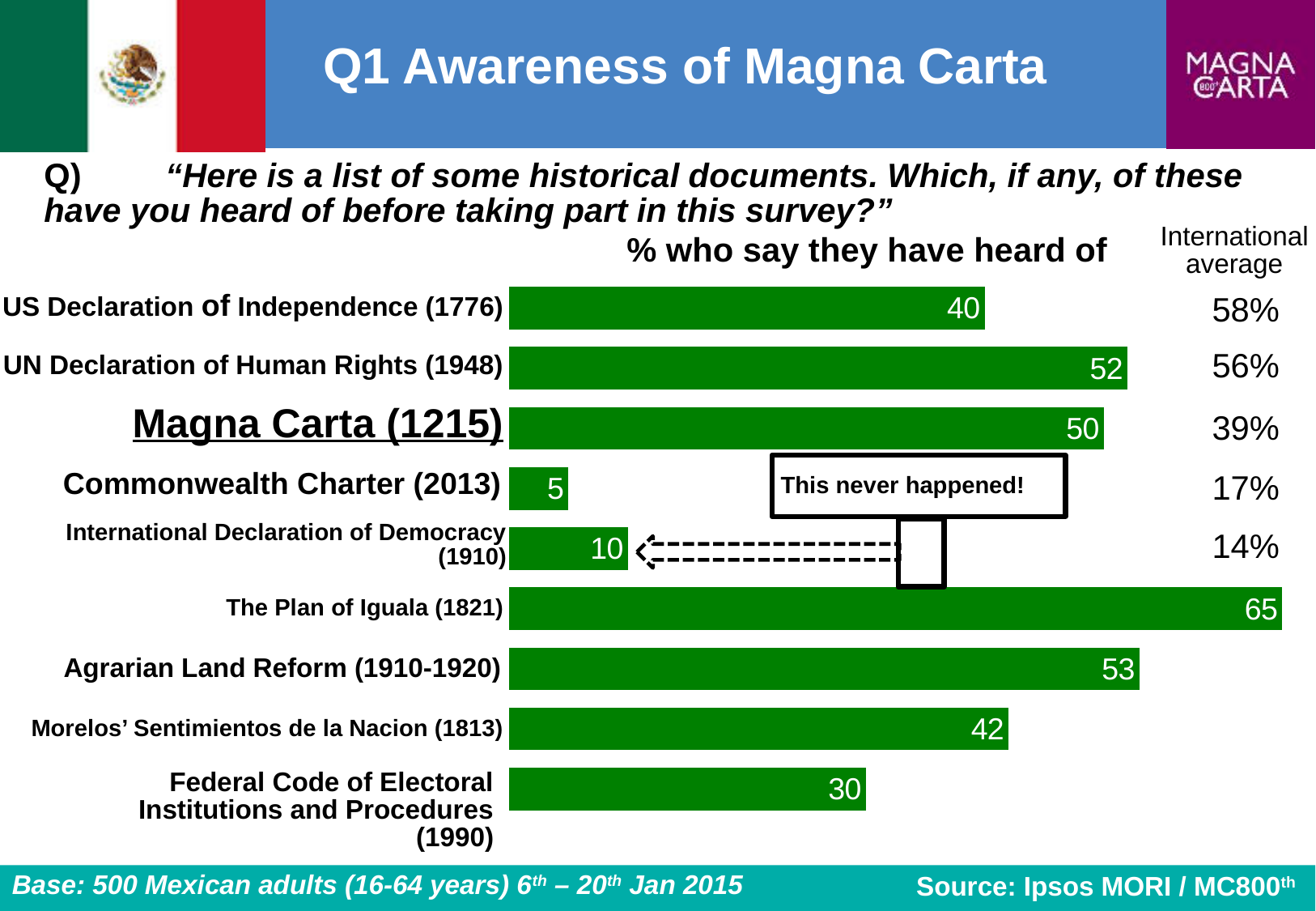
What percentage say they have heard of the Magna Carta (1215)? 50 Which has a higher value: Agrarian Land Reform (1910-1920) or Morelos' Sentimientos de la Nacion (1813)? Agrarian Land Reform (1910-1920) What is the value shown for The Plan of Iguala (1821)? 65 What is the difference between the values for the UN Declaration of Human Rights (1948) and the US Declaration of Independence (1776)? 12 What is the value shown for the Commonwealth Charter (2013)? 5 What is the difference between the values for The Plan of Iguala (1821) and the International Declaration of Democracy (1910)? 55 What is the value shown for the Federal Code of Electoral Institutions and Procedures (1990)? 30 Which document has the lowest percentage of people who say they have heard of it? Commonwealth Charter (2013) How many documents are listed in the bar chart? 9 What colour are the bars in the chart? Green Which document has the highest percentage of people who say they have heard of it? The Plan of Iguala (1821) What type of chart is shown on the slide? Bar chart